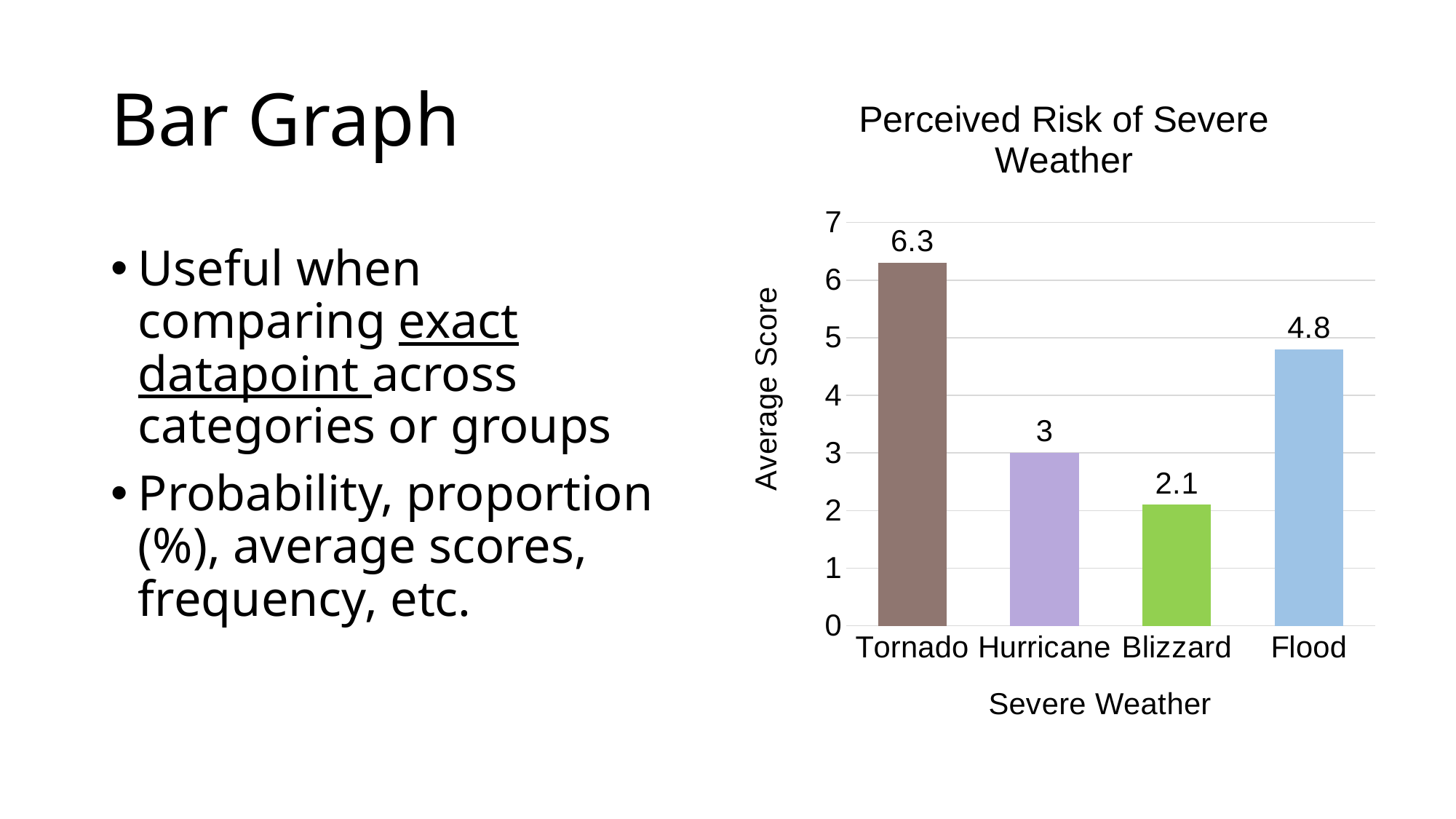
What is the average score for Tornado? 6.3 What is the average score for Blizzard? 2.1 Is the value for Flood greater or less than 4? greater What is the title of the chart? Perceived Risk of Severe Weather How many severe weather categories are shown in the chart? 4 What kind of chart is shown on the slide? Bar chart Which has a higher average score, Hurricane or Flood? Flood What is the difference between the average scores for Tornado and Flood? 1.5 What is the average score for Hurricane? 3 What is the average score for Flood? 4.8 Which severe weather category has the highest average score? Tornado Which severe weather category has the lowest average score? Blizzard